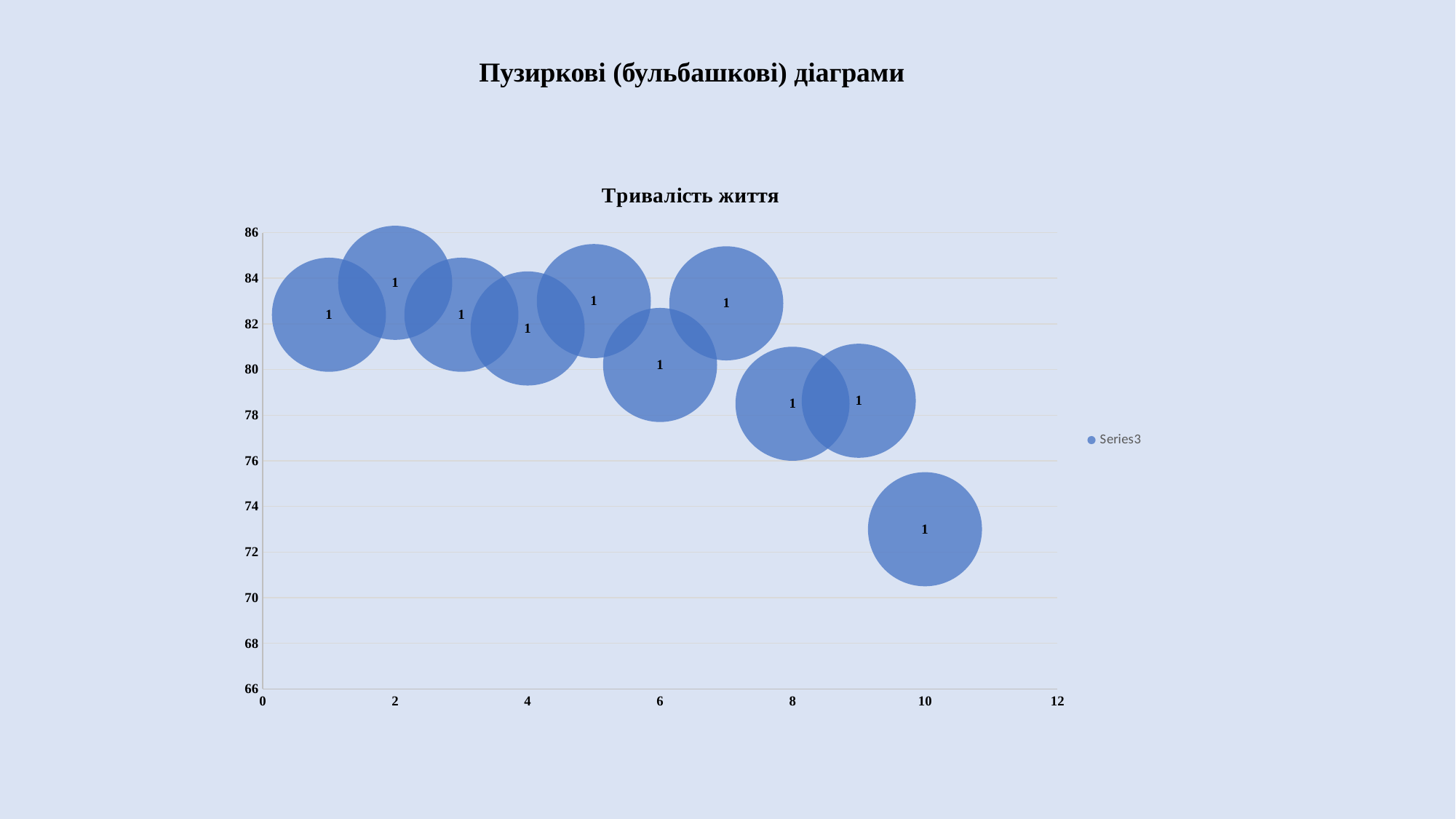
How many bubbles are plotted on the chart? 10 Which bubble has the larger value, the one at x = 7 or the one at x = 8? x = 7 What data label is printed on the bubble at x = 10? 1 What kind of chart is shown on the slide? bubble chart How many series does the legend list? 1 What is the title of the chart? Тривалість життя Is the value for the bubble at x = 8 greater or less than 80? less Do the bubble values generally rise or fall as x increases? fall Is the value for the bubble at x = 2 greater or less than 82? greater Is the value for the bubble at x = 10 greater or less than 74? less At which x value is the lowest bubble on the chart? 10 What is the name of the series shown in the legend? Series3